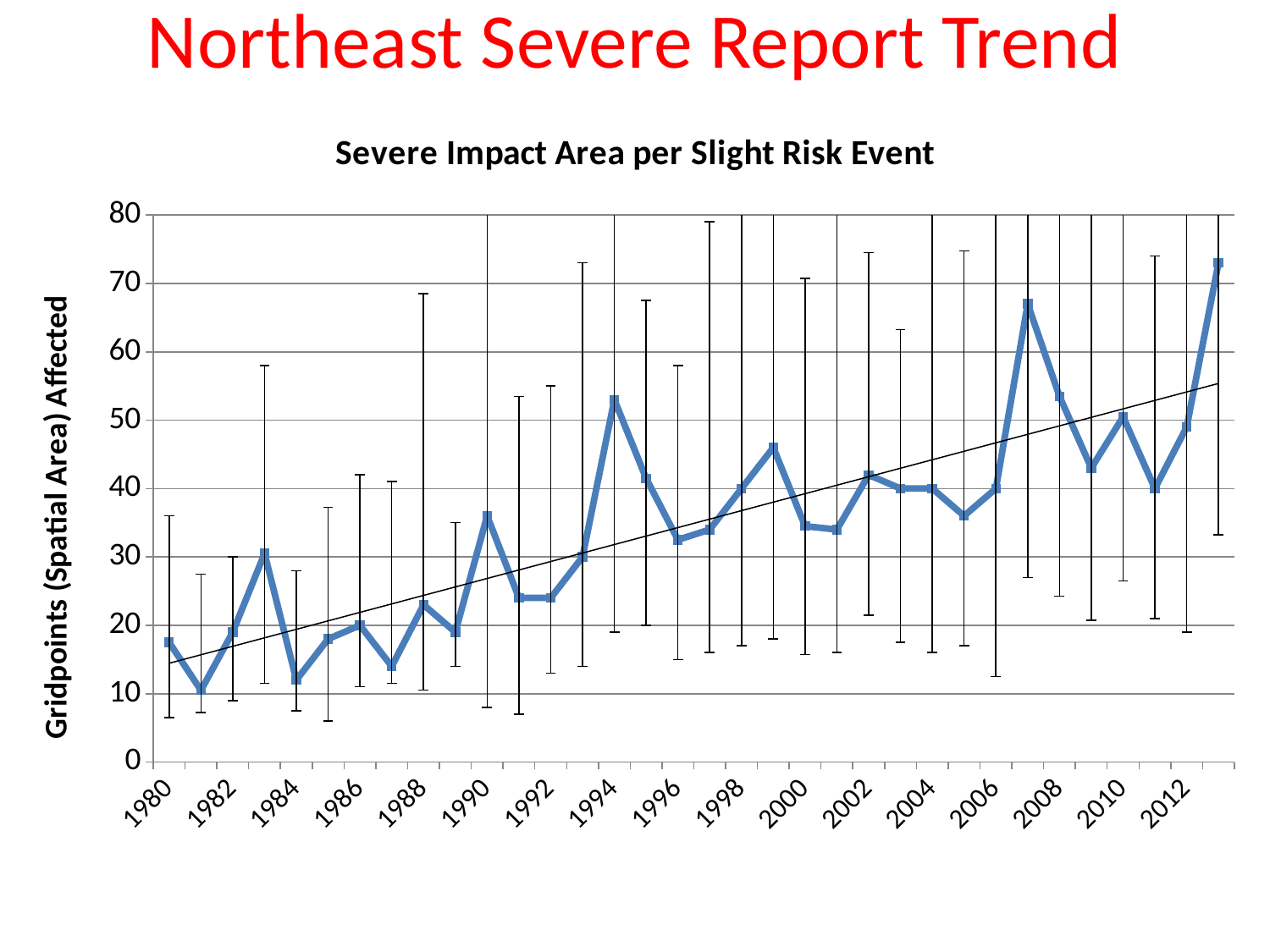
Is the value for 2013 greater or less than 70? greater What is the title of the chart? Severe Impact Area per Slight Risk Event What type of chart is shown on the slide? line chart Is the value for 1994 greater or less than 50? greater Is the value for 1981 greater or less than 20? less What is the label on the vertical axis of the chart? Gridpoints (Spatial Area) Affected Which year has the highest value on the chart? 2013 Which year has the larger value, 1990 or 1994? 1994 Which year has the larger value, 2007 or 2008? 2007 Overall, do the values rise or fall from 1980 to 2013? rise